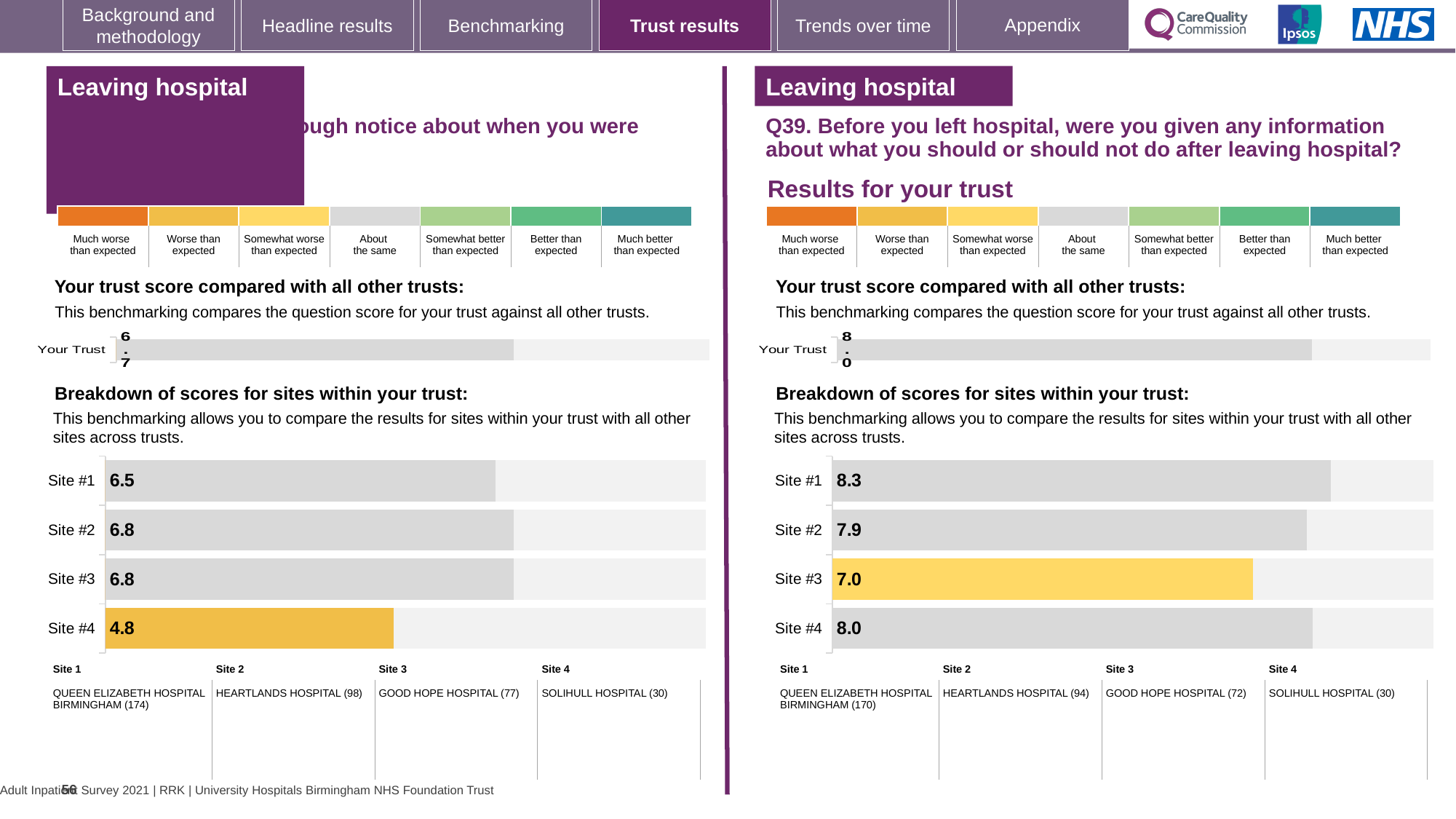
On the right-hand chart (Q39), which site has the highest score? Site #1 How many sites are shown in the right-hand site breakdown chart? 4 What type of chart is used for the site breakdown on the right-hand side? Bar chart On the left-hand site breakdown chart, which site has the lowest score? Site #4 On the right-hand chart (Q39), what is the score for Site #1? 8.3 On the right-hand chart (Q39), which has the higher score, Site #2 or Site #4? Site #4 On the right-hand chart (Q39), which site has the lowest score? Site #3 On the right-hand chart (Q39), what is the difference between the scores for Site #1 and Site #3? 1.3 On the right-hand chart (Q39), what is the 'Your Trust' score? 8.0 On the left-hand chart, what is the 'Your Trust' score? 6.7 On the left-hand site breakdown chart, what is the score for Site #4? 4.8 On the left-hand site breakdown chart, what is the difference between the scores for Site #2 and Site #4? 2.0